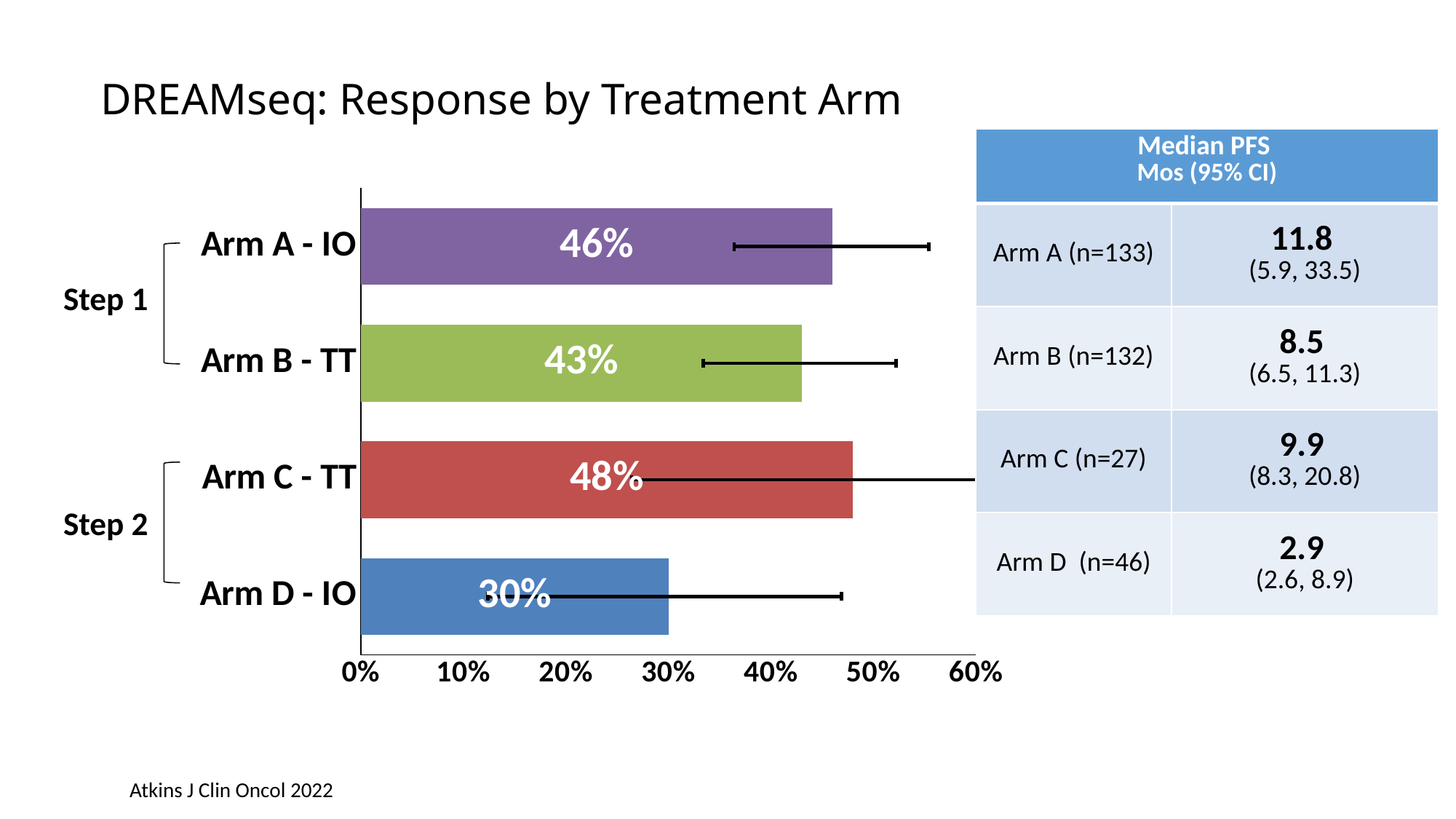
What kind of chart is used to show response by treatment arm? Bar chart Which arm has the lowest response rate? Arm D - IO Which two arms are grouped under Step 2? Arm C - TT and Arm D - IO What is the response rate for Arm B - TT? 43% What is the response rate for Arm D - IO? 30% What is the difference in response rate between Arm A - IO and Arm B - TT? 3% What is the response rate for Arm C - TT? 48% What is the response rate for Arm A - IO? 46% Which has a higher response rate, Arm A - IO or Arm D - IO? Arm A - IO How many treatment arms are shown in the bar chart? 4 Which arm has the highest response rate? Arm C - TT What is the difference in response rate between Arm C - TT and Arm D - IO? 18%